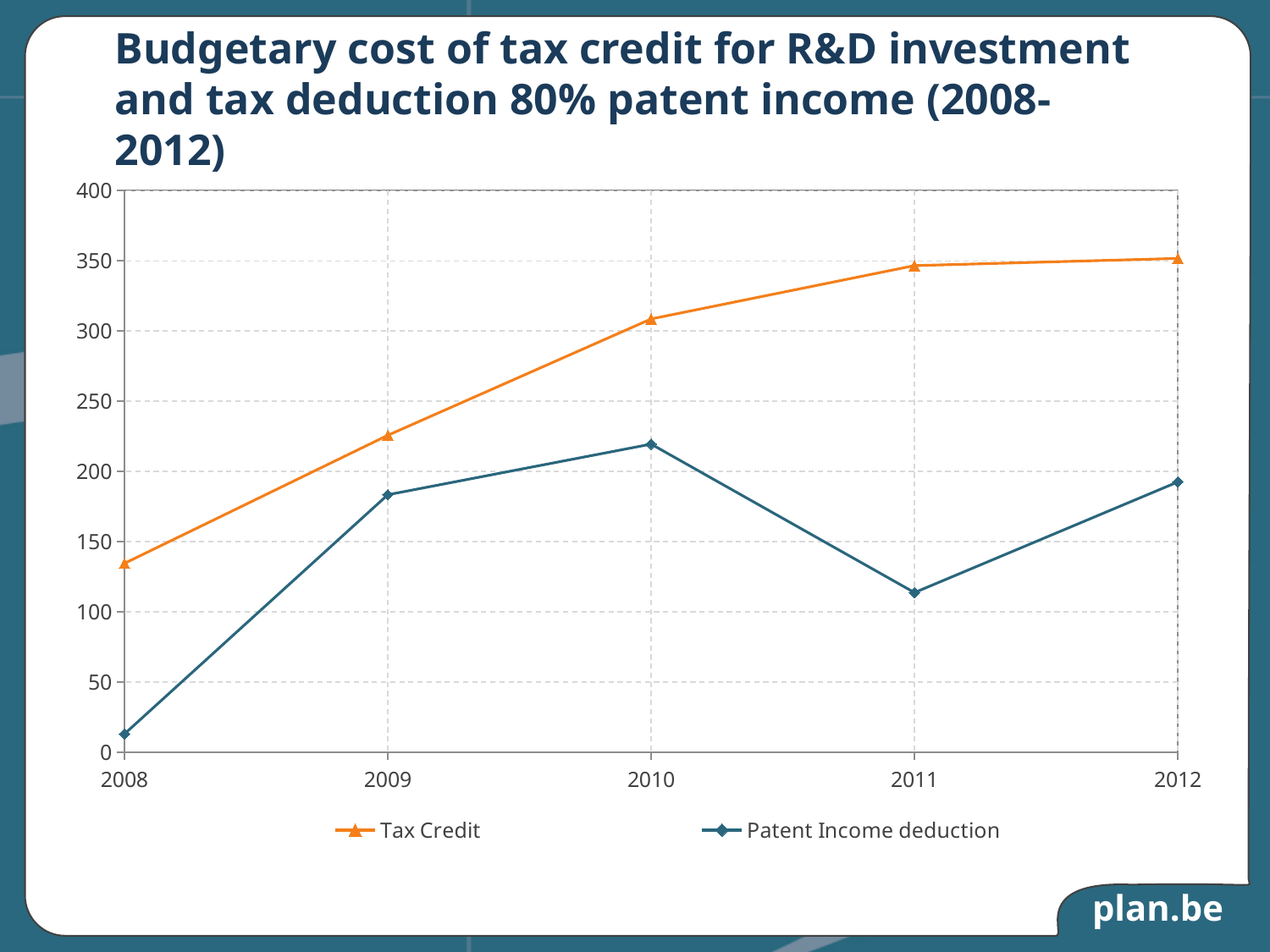
Is the Patent Income deduction value for 2008 greater or less than 50? less In which year is the Patent Income deduction value highest? 2010 How many years are plotted along the x axis? 5 Does the Tax Credit series rise or fall from 2008 to 2012? rise In 2011, which series has the larger value, Tax Credit or Patent Income deduction? Tax Credit What kind of chart is shown on the slide? line chart In which year is the Tax Credit value lowest? 2008 In which year is the Patent Income deduction value lowest? 2008 Is the Tax Credit value for 2008 greater or less than 150? less How many series does the legend list? 2 Is the Patent Income deduction value for 2011 greater or less than 150? less